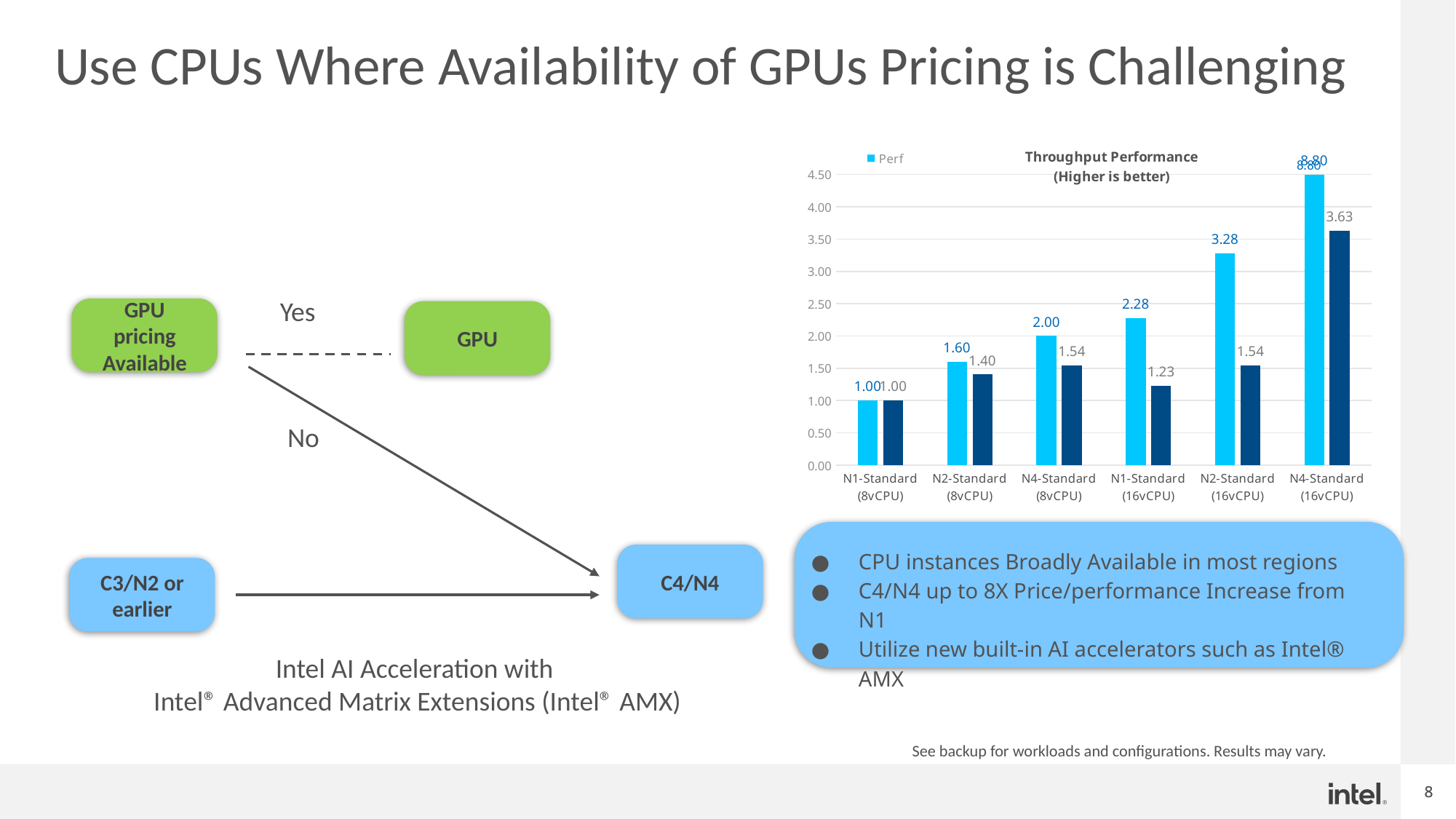
What is the title of the chart on the slide? Throughput Performance (Higher is better) In the Throughput Performance chart, is the light blue bar for N2-Standard (16vCPU) greater or less than 3.00? greater In the Throughput Performance chart, which category has the lowest dark blue bar? N1-Standard (8vCPU) What kind of chart is shown under the title "Throughput Performance (Higher is better)"? bar chart In the Throughput Performance chart, what is the value of the dark blue bar for N4-Standard (16vCPU)? 3.63 In the Throughput Performance chart, what is the difference between the light blue bar (3.28) and the dark blue bar (1.54) for N2-Standard (16vCPU)? 1.74 In the Throughput Performance chart, which category has the highest light blue bar? N4-Standard (16vCPU) In the Throughput Performance chart, what is the value of the light blue bar for N2-Standard (8vCPU)? 1.60 In the Throughput Performance chart, for N4-Standard (8vCPU), which bar is larger, the light blue or the dark blue? light blue How many instance categories are shown on the x axis of the Throughput Performance chart? 6 In the Throughput Performance chart, what is the value of the dark blue bar for N1-Standard (16vCPU)? 1.23 In the Throughput Performance chart, what is the value of the light blue bar for N1-Standard (16vCPU)? 2.28